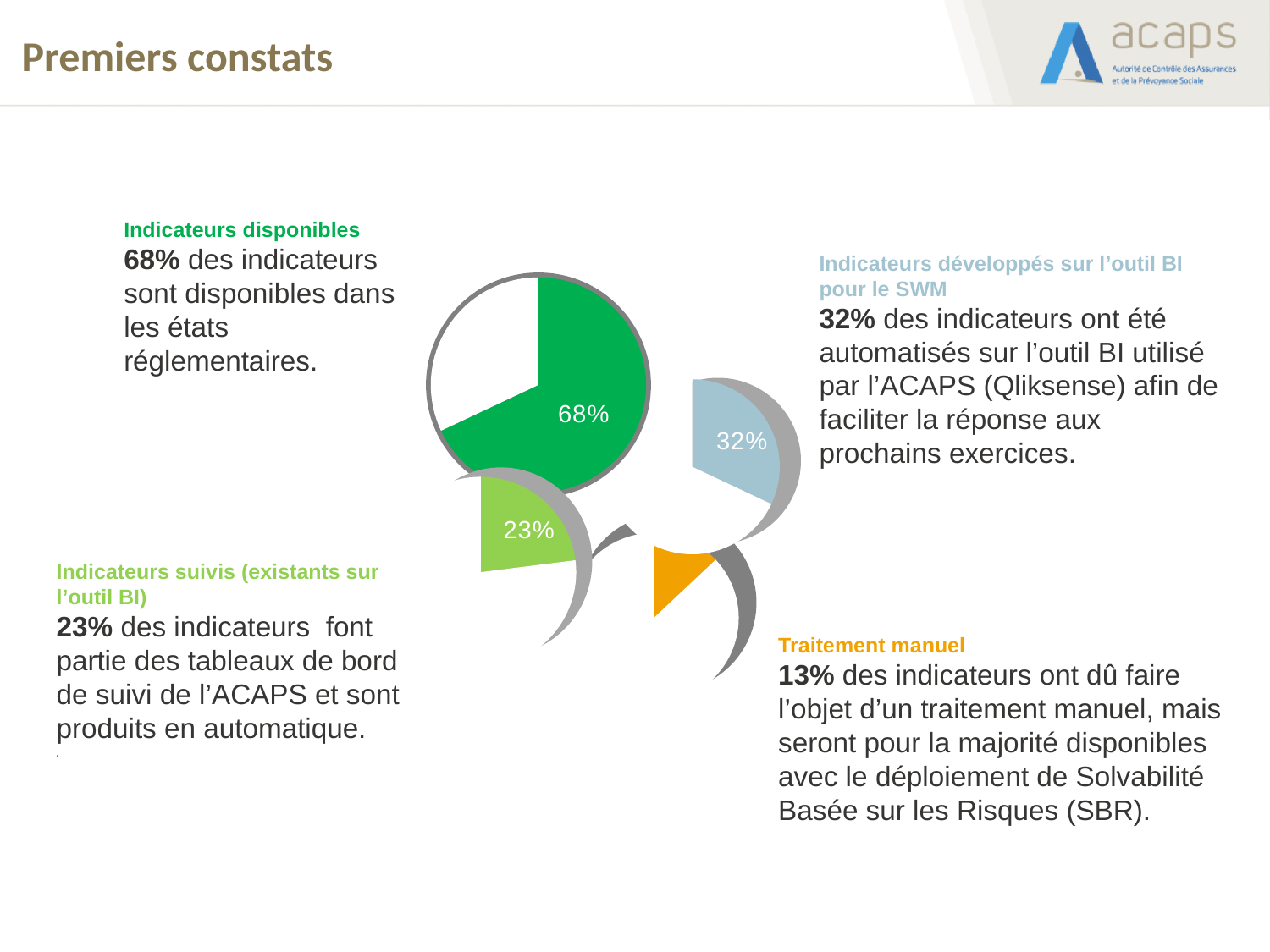
Among the pie charts with printed labels, which one shows the highest value? The dark green pie chart (68%) Which shows a larger value, the dark green pie chart or the light blue pie chart? The dark green pie chart (68%) Which colour pie chart corresponds to the 'Traitement manuel' text block? Orange What is the difference between the value on the light blue pie chart and the value on the light green pie chart? 9 percentage points What percentage is shown on the large dark green pie chart in the centre of the slide? 68% What is the difference between the value on the dark green pie chart and the value on the light green pie chart? 45 percentage points What percentage is shown on the small light green pie chart below the large green one? 23% What kind of charts are used on this slide? Pie charts What colour is the slice labelled 32%? Light blue How many pie charts are shown on the slide? 4 Among the pie charts with printed labels, which one shows the lowest value? The light green pie chart (23%) What percentage is shown on the light blue pie chart on the right? 32%